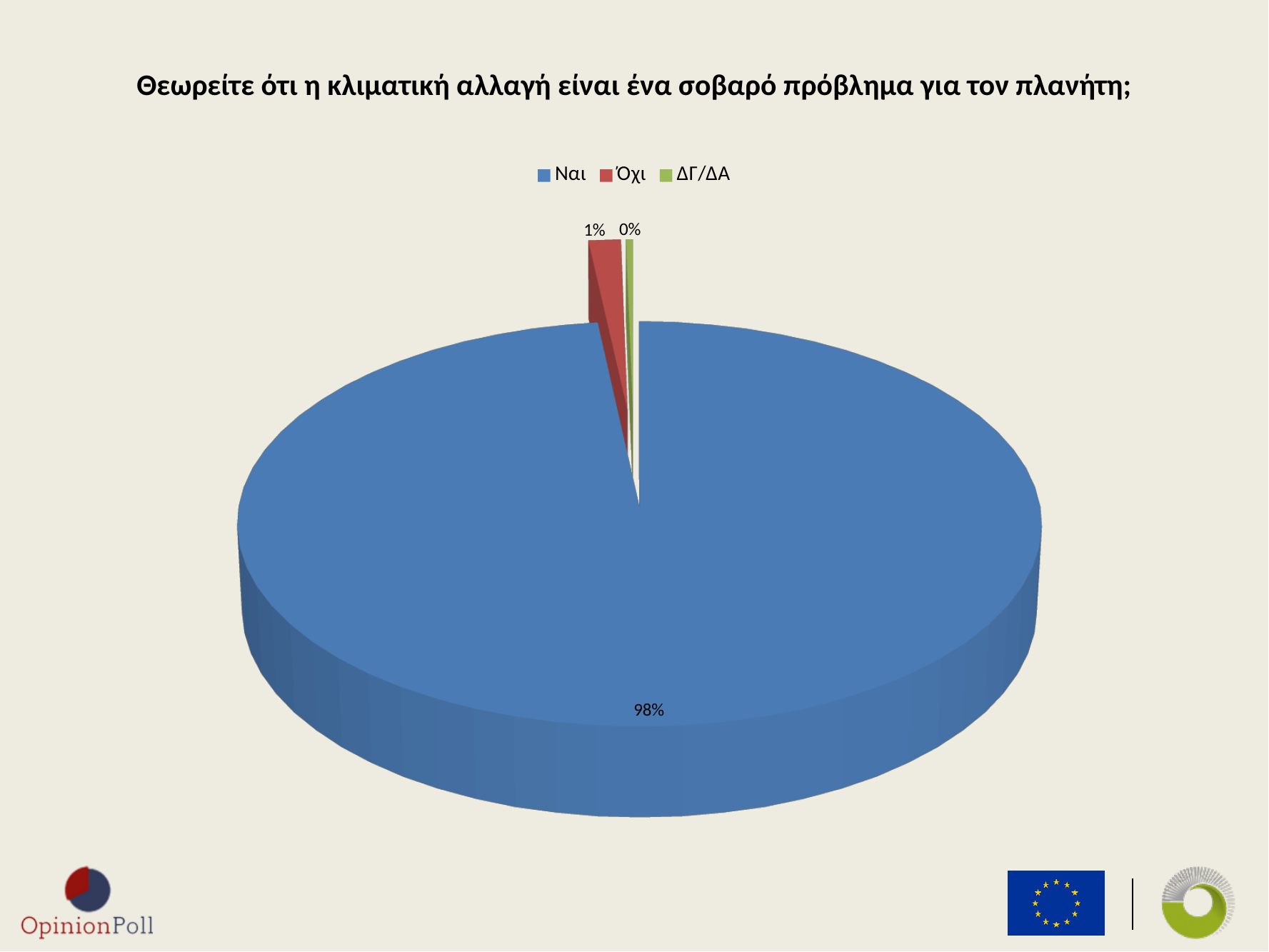
Which category has the largest share of the pie? Ναι How many categories does the pie chart show? 3 Which is larger, the value for Όχι or the value for ΔΓ/ΔΑ? Όχι How many entries does the legend list? 3 What is the value for Ναι? 98% Which category has the smallest share of the pie? ΔΓ/ΔΑ What is the difference between the values for Ναι and Όχι? 97% What colour is the slice for Ναι? blue What kind of chart is shown on the slide? pie chart What is the title of the chart? Θεωρείτε ότι η κλιματική αλλαγή είναι ένα σοβαρό πρόβλημα για τον πλανήτη; What is the value for Όχι? 1% What is the value for ΔΓ/ΔΑ? 0%